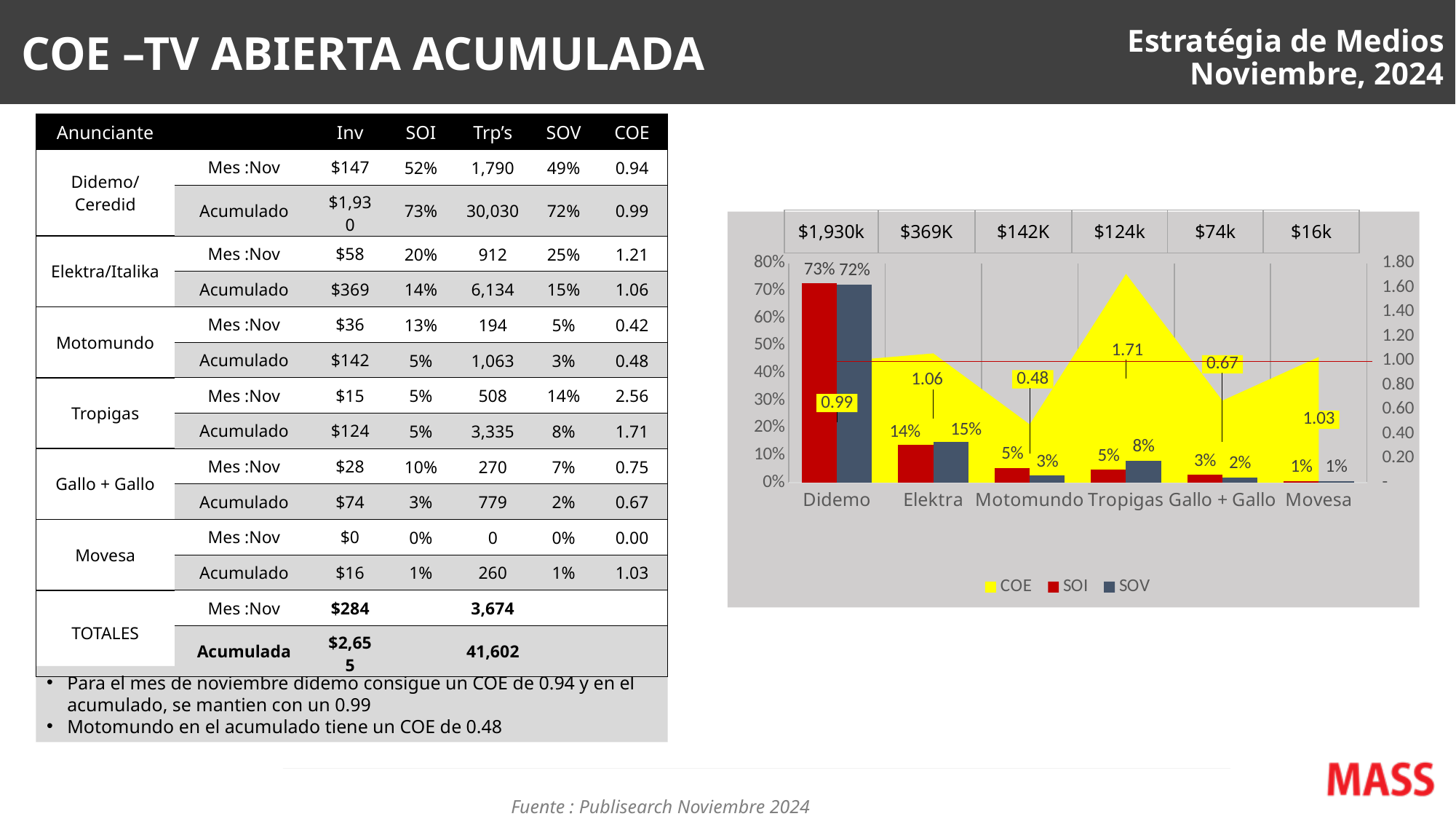
In the chart, which category has the highest COE value? Tropigas In the chart, what is the COE value for Tropigas? 1.71 How many series does the chart's legend list? 3 In the chart, which category has the lowest COE value? Motomundo In the chart, which category has the highest SOI value? Didemo In the chart, what is the difference between the SOV value for Tropigas and the SOV value for Motomundo? 5% In the chart, what is the SOI value for Didemo? 73% In the chart, which is larger for Elektra: the SOI value or the SOV value? SOV How many categories are shown on the x axis of the chart? 6 In the chart, what is the SOV value for Elektra? 15% In the chart, what colour is used for the COE series? Yellow In the chart, what is the COE value for Motomundo? 0.48